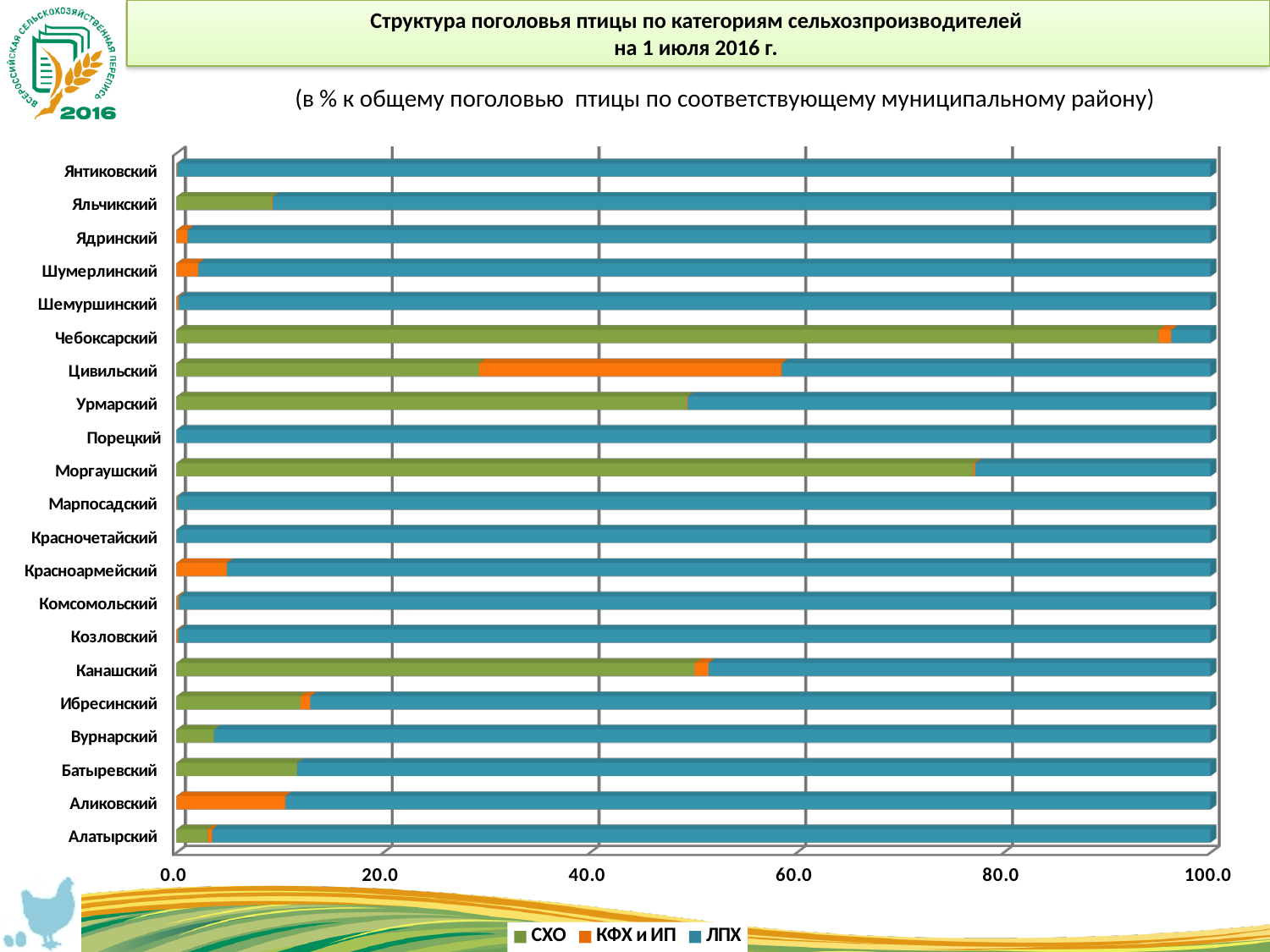
How many series does the legend list? 3 Which district has the largest СХО share? Чебоксарский Is the СХО value for Цивильский greater or less than 40.0? less Which district has the largest КФХ и ИП share? Цивильский What kind of chart is shown on the slide? Stacked bar chart Is the СХО value for Яльчикский greater or less than 20.0? less Is the СХО value for Моргаушский greater or less than 60.0? greater How many municipal districts (categories) are plotted on the chart? 21 Which series are listed in the legend? СХО, КФХ и ИП, ЛПХ Which district has the larger СХО share, Моргаушский or Канашский? Моргаушский